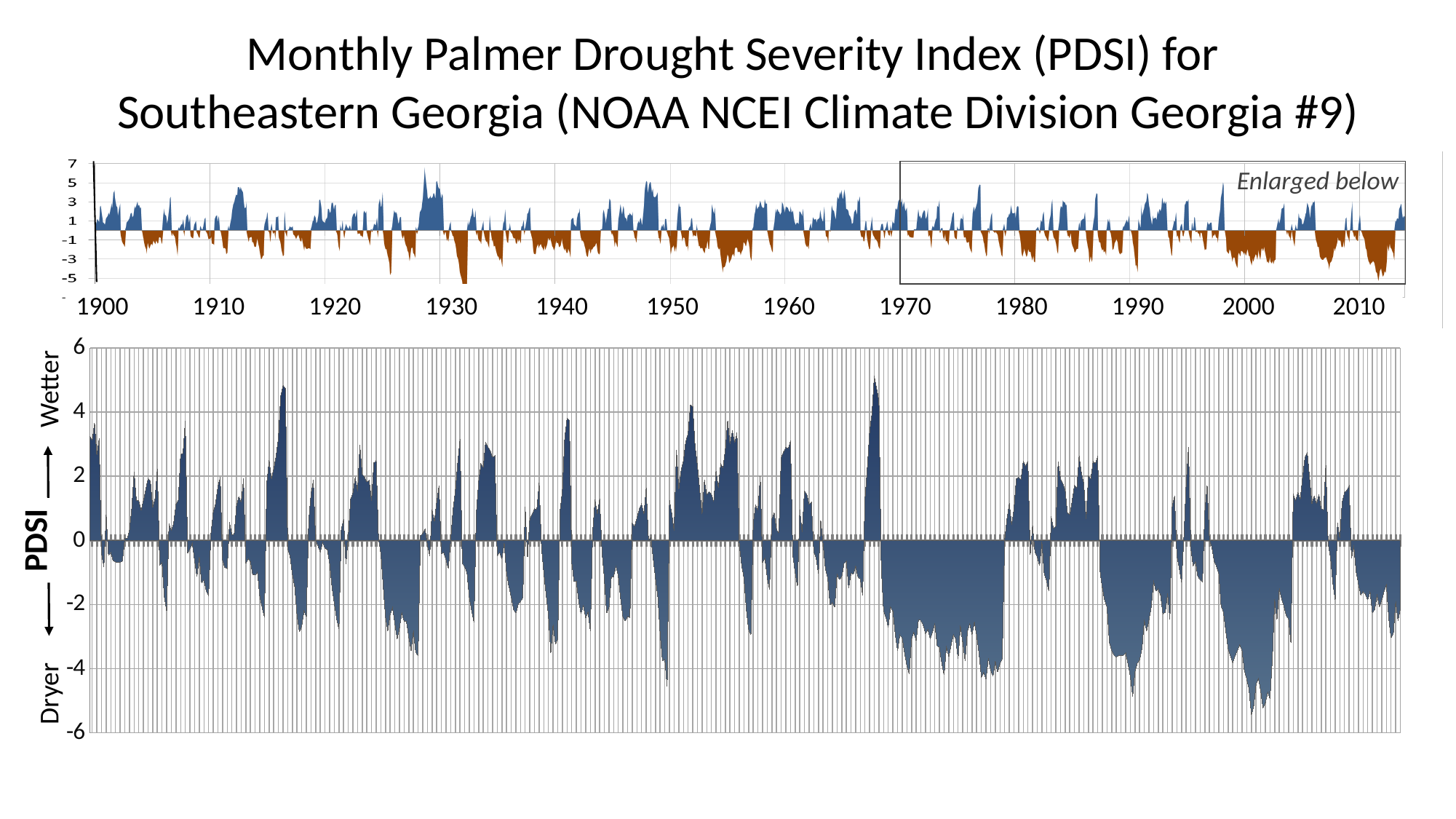
In the top chart, is the peak value around 1928 greater or less than 3? greater In the top chart, what colour are the negative (drought) values shown in? brown In the top chart, what is the first year labelled on the x axis? 1900 In the top chart, is the lowest value around 1931 greater or less than -3? less In the bottom (enlarged) chart, is the deepest trough in the right-hand portion greater or less than -4? less In the top chart, what is the last year labelled on the x axis? 2010 What kind of chart is the top chart on the slide? area chart In the top chart, how many year labels are shown on the x axis? 12 In the bottom (enlarged) chart, what is the lowest value shown on the y axis? -6 What is the title of the slide's chart? Monthly Palmer Drought Severity Index (PDSI) for Southeastern Georgia (NOAA NCEI Climate Division Georgia #9) In the bottom (enlarged) chart, what is the highest value shown on the y axis? 6